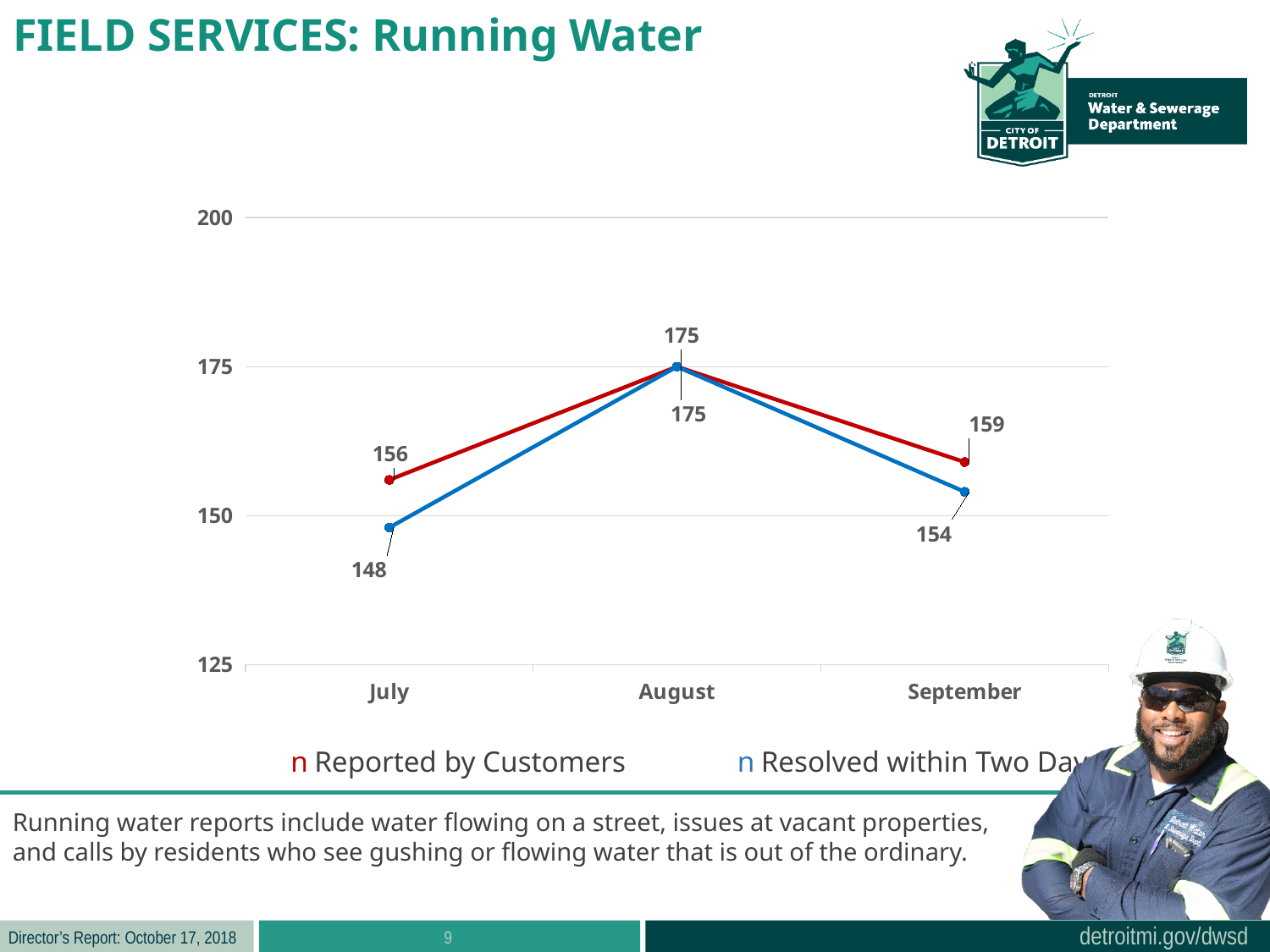
What is the difference between Reported by Customers and Resolved within Two Days in September? 5 How many months are shown on the x axis of the chart? 3 What is the value for Reported by Customers in July? 156 What is the value for Resolved within Two Days in August? 175 In which month is the Resolved within Two Days value lowest? July Which is larger in July: Reported by Customers or Resolved within Two Days? Reported by Customers What is the value for Reported by Customers in September? 159 How many series does the chart's legend list? 2 Which colour is used for the Reported by Customers line? Red What kind of chart is shown on the slide? Line chart In which month is the Reported by Customers value highest? August What is the value for Resolved within Two Days in July? 148